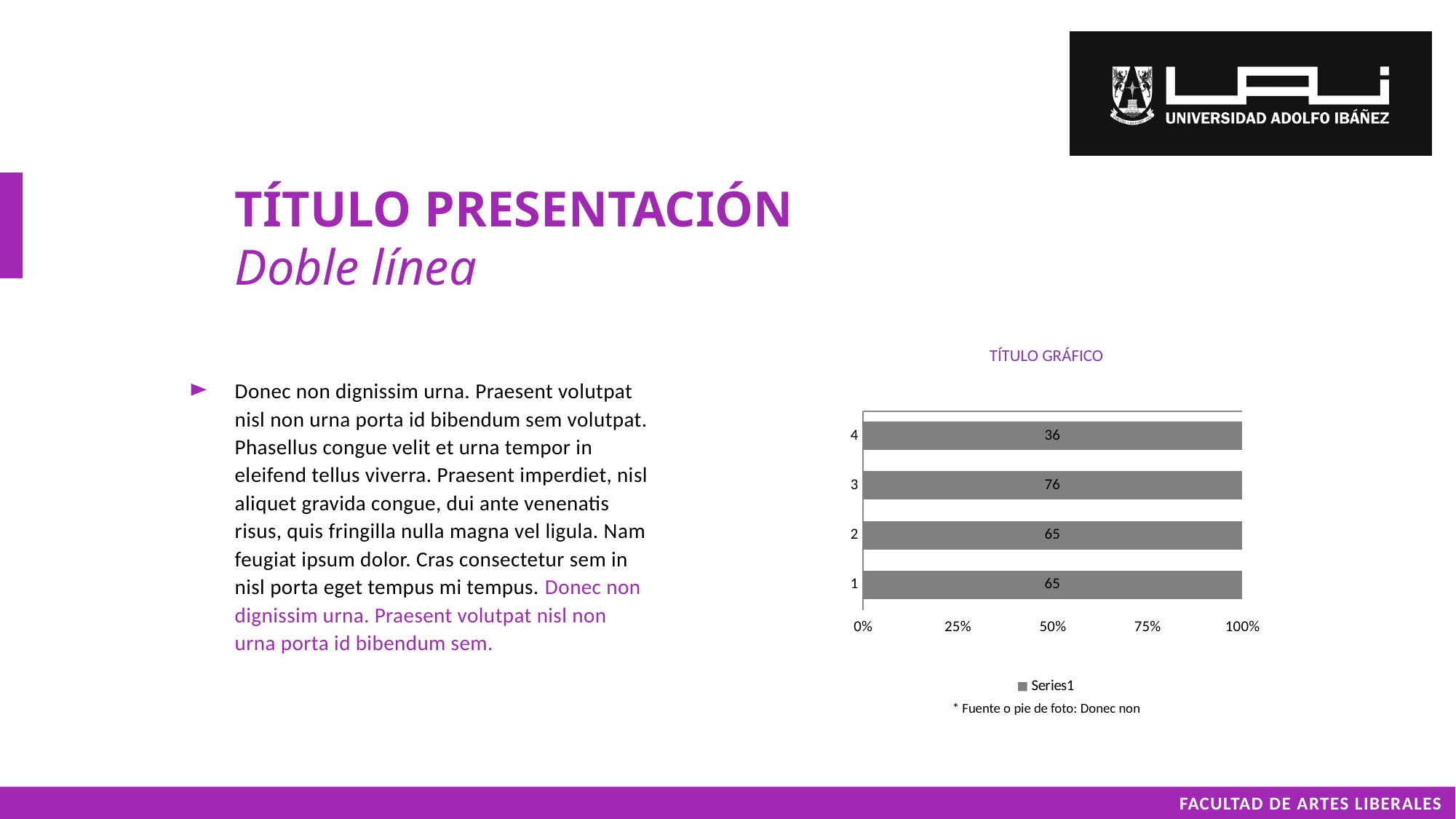
What is the data label on the bar for category 2? 65 Which has the larger data label, category 2 or category 4? 2 What is the data label on the bar for category 3? 76 What is the title of the chart? TÍTULO GRÁFICO What is the difference between the data labels for category 3 and category 4? 40 How many categories are shown on the chart? 4 What is the data label on the bar for category 4? 36 What kind of chart is shown on the slide? bar chart How many series does the legend list? 1 What is the data label on the bar for category 1? 65 Which category has the lowest data label value? 4 Which category has the highest data label value? 3